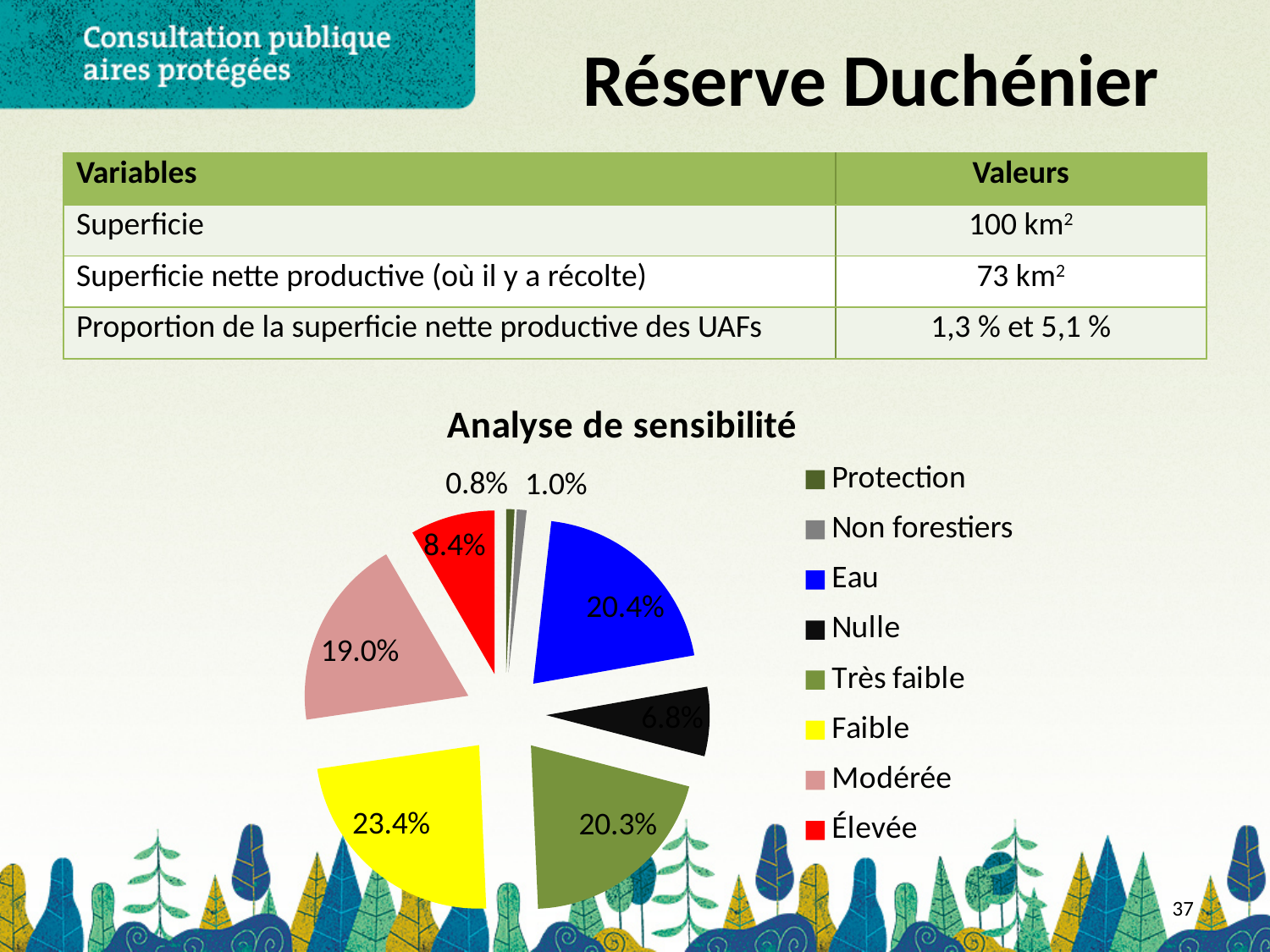
What is the value of the "Eau" slice in the pie chart? 20.4% Which category has the largest slice in the "Analyse de sensibilité" pie chart? Faible What is the difference in percentage points between the "Faible" and "Modérée" slices? 4.4% What is the value of the "Nulle" slice in the pie chart? 6.8% What percentage is shown for the "Protection" slice? 0.8% What percentage does the "Faible" slice represent in the "Analyse de sensibilité" pie chart? 23.4% How many categories does the legend of the pie chart list? 8 What kind of chart is shown under the title "Analyse de sensibilité"? pie chart What share of the pie chart is labelled "Modérée"? 19.0% What is the difference between the "Élevée" and "Nulle" slices? 1.6% What percentage is shown for the "Élevée" slice? 8.4% What colour is used for the "Eau" slice in the pie chart? blue